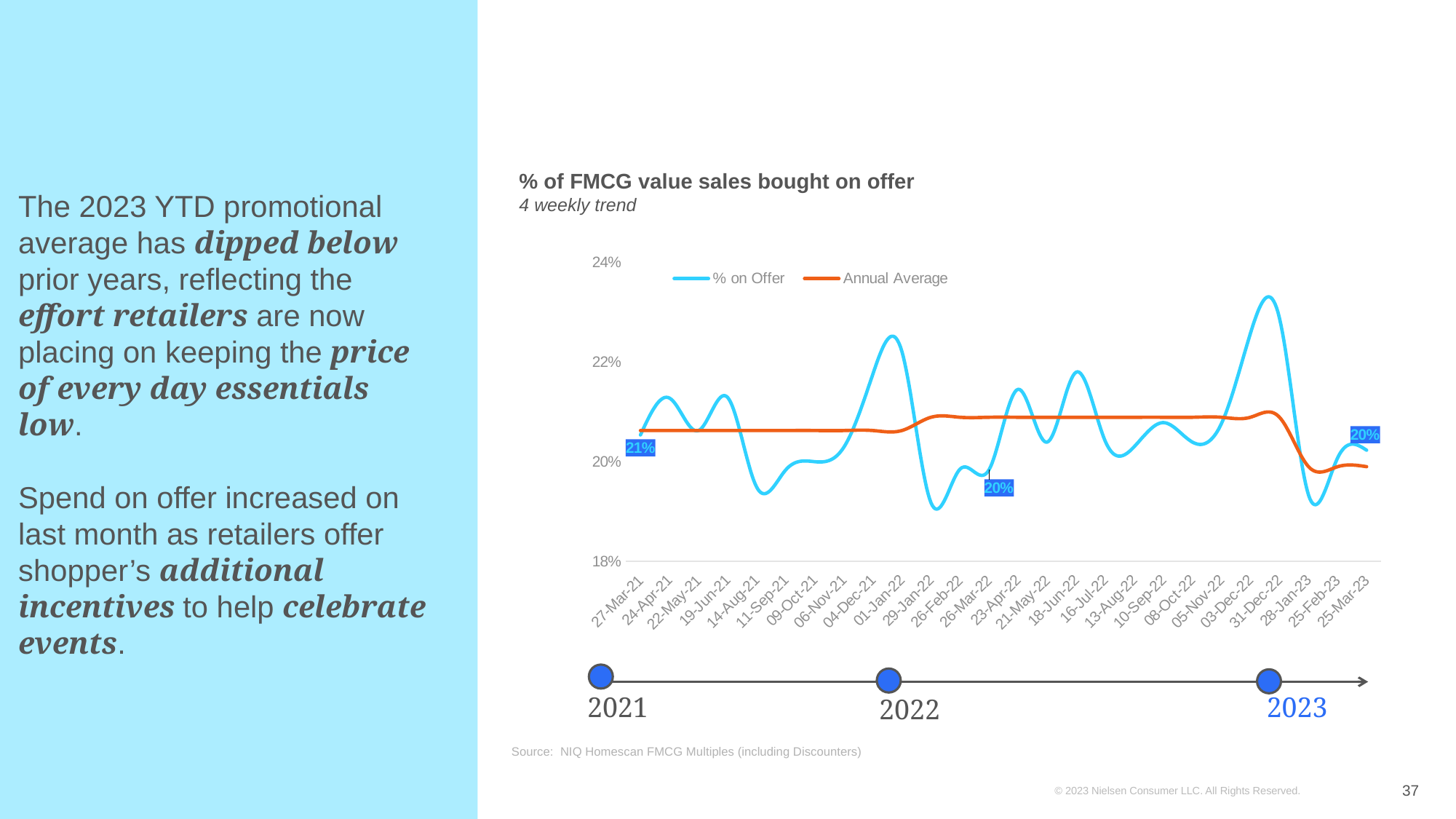
Is the % on Offer value around 28-Jan-23 greater or less than 20%? less What kind of chart is shown on the slide? line chart What is the % on Offer value labelled at 26-Mar-22? 20% What is the difference between the labelled % on Offer values at 27-Mar-21 and 25-Mar-23? 1 percentage point Which is larger, the labelled % on Offer value at 27-Mar-21 or at 25-Mar-23? 27-Mar-21 What is the % on Offer value labelled at 27-Mar-21? 21% How many series does the chart legend list? 2 Around which date does the % on Offer line reach its highest point? 31-Dec-22 What is the % on Offer value labelled at 25-Mar-23? 20% Is the peak % on Offer value around 31-Dec-22 greater or less than 22%? greater What is the title of the chart? % of FMCG value sales bought on offer What are the two series named in the chart legend? % on Offer and Annual Average